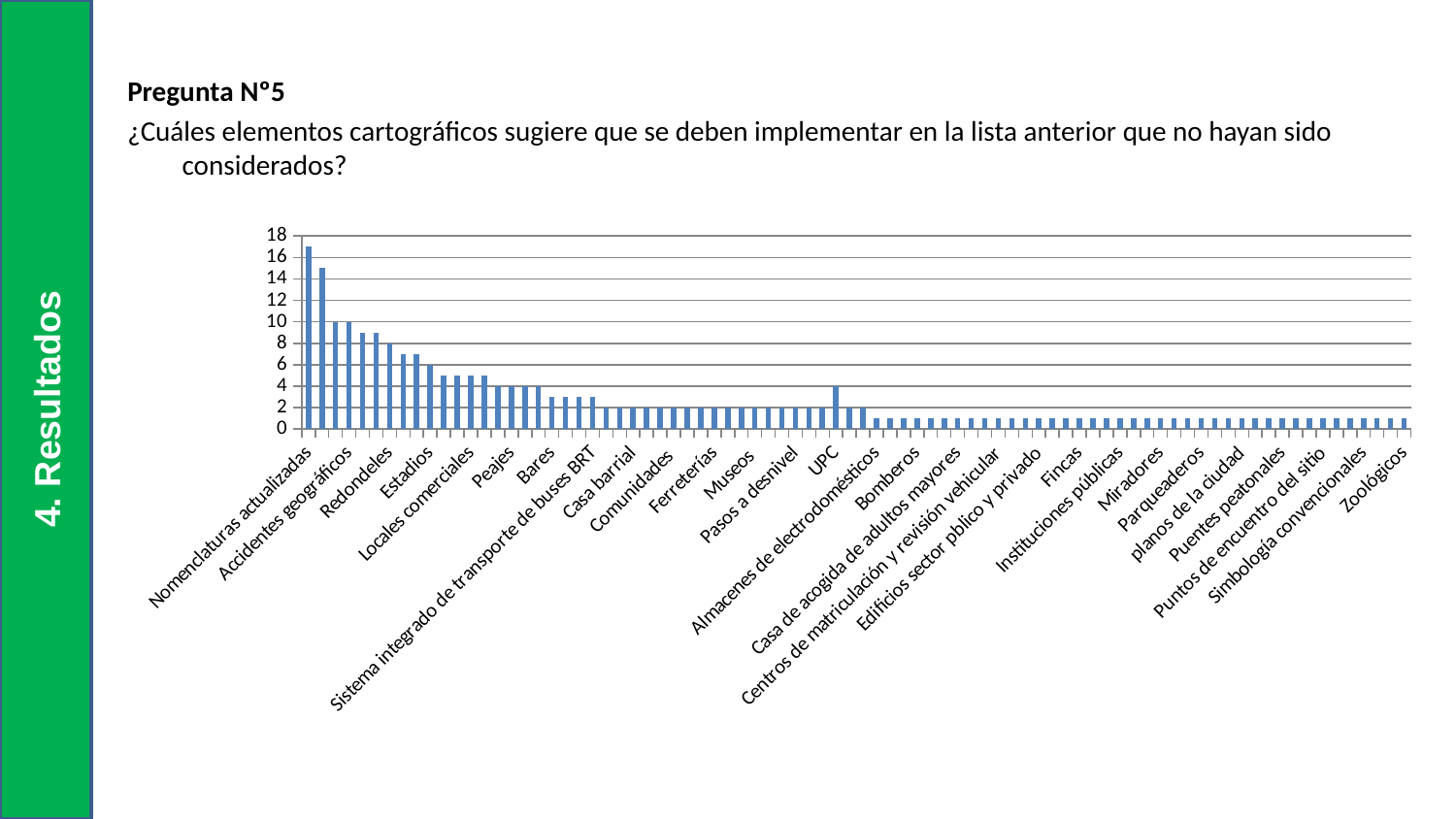
Is the value for Nomenclaturas actualizadas greater or less than 14? greater Is the value for Bomberos greater or less than 2? less Which category has the highest value in the chart? Nomenclaturas actualizadas Is the value for UPC greater or less than 2? greater Which has the larger value, UPC or Bomberos? UPC Do the values generally rise or fall from left to right along the x axis? fall What kind of chart is shown on the slide? bar chart What is the highest tick value shown on the vertical axis of the chart? 18 Which has the larger value, Nomenclaturas actualizadas or Zoológicos? Nomenclaturas actualizadas